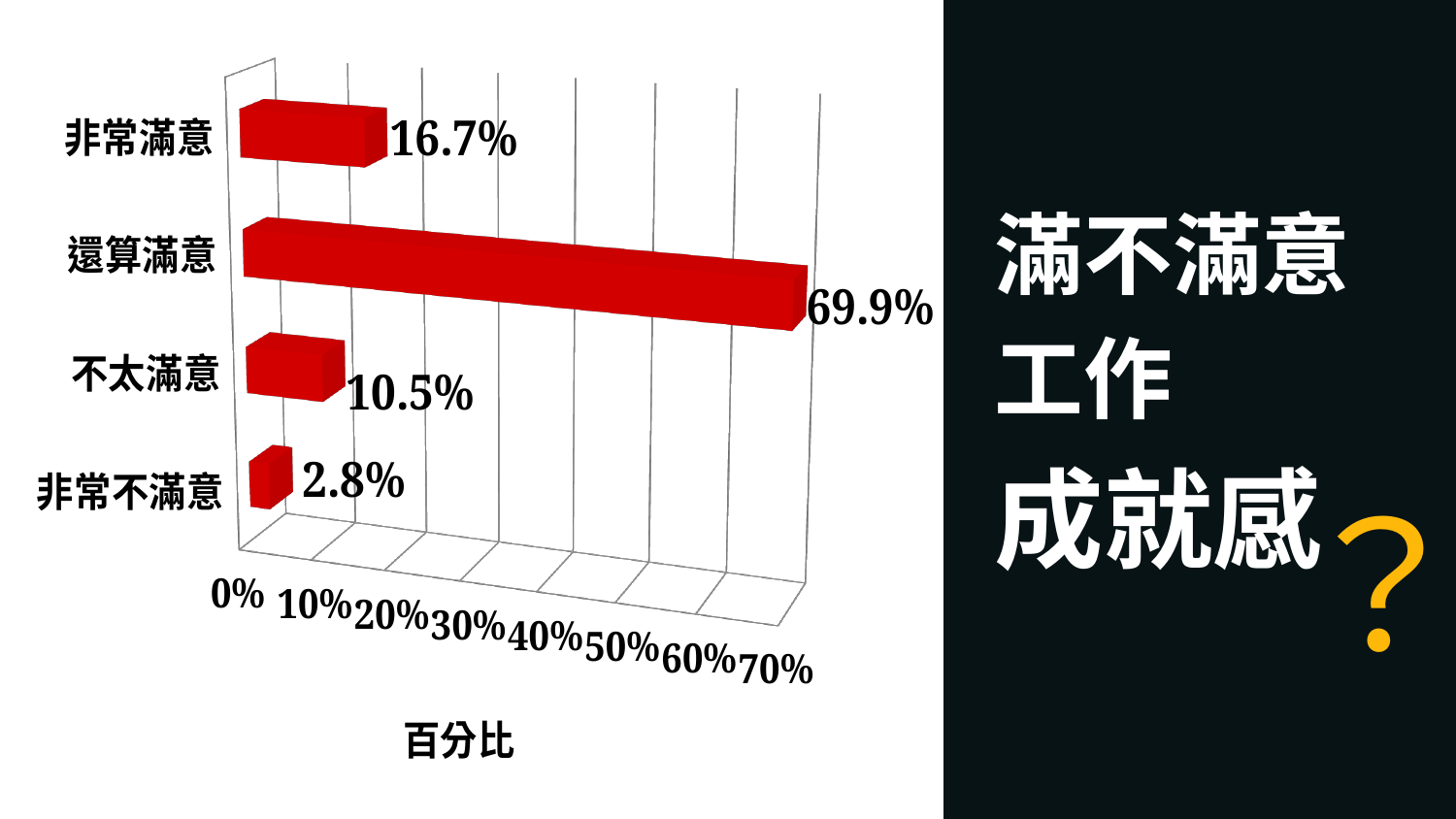
Which category has the highest value? 還算滿意 What is the value for 非常不滿意? 2.8% What is the value for 還算滿意? 69.9% What is the value for 不太滿意? 10.5% How many categories are shown in the chart? 4 What is the value for 非常滿意? 16.7% What kind of chart is shown on the slide? bar chart What is the difference between the values for 不太滿意 and 非常不滿意? 7.7% Is the value for 還算滿意 greater or less than 60%? greater Which category has the lowest value? 非常不滿意 Which is larger, the value for 非常滿意 or the value for 不太滿意? 非常滿意 What is the difference between the values for 還算滿意 and 非常滿意? 53.2%